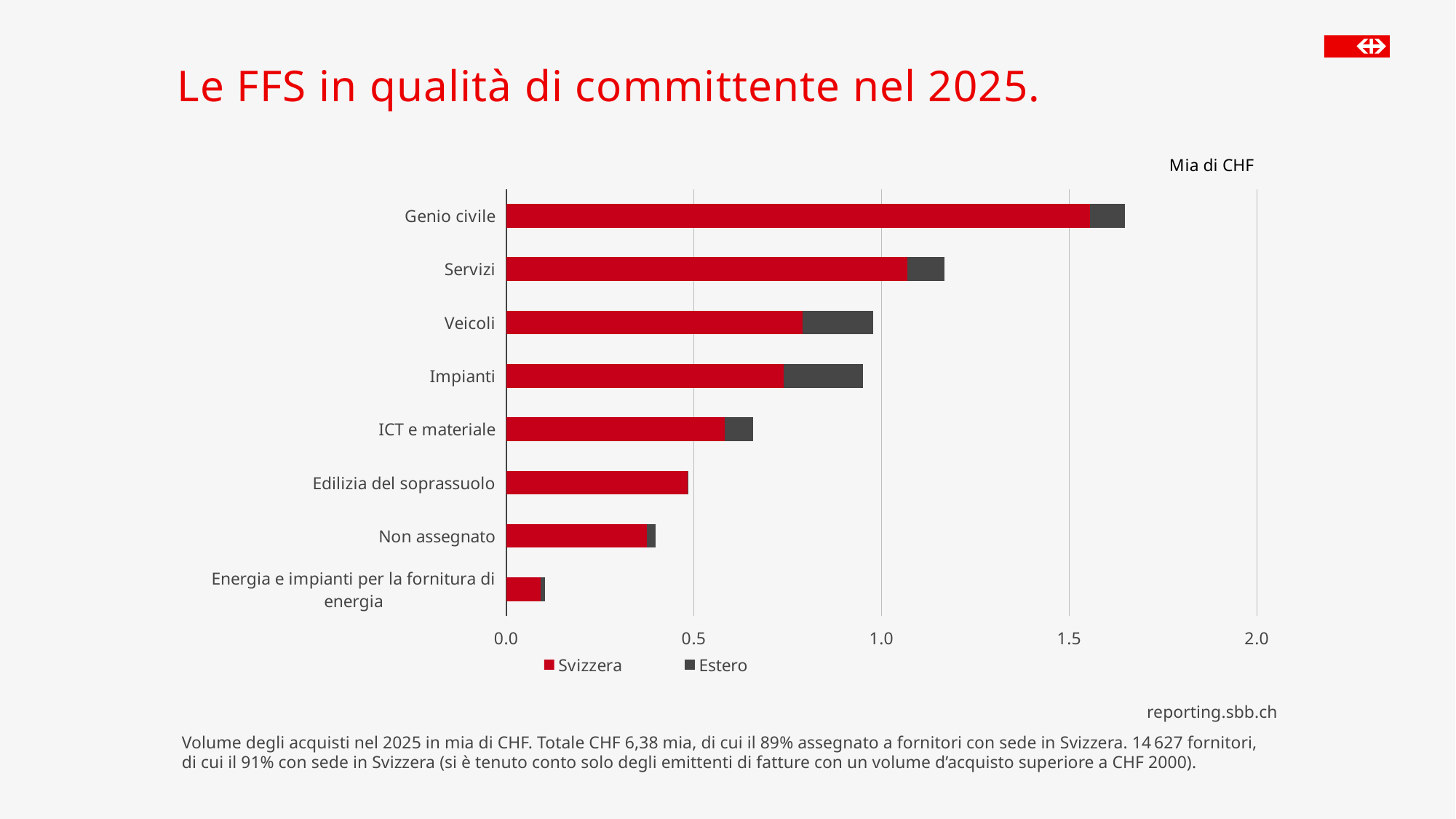
Which has the larger total bar, Servizi or Veicoli? Servizi Which category has the shortest bar in the chart? Energia e impianti per la fornitura di energia Which category has the longest bar in the chart? Genio civile How many series does the legend list? 2 Is the total value for Genio civile greater or less than 1.5? greater What unit is indicated above the chart? Mia di CHF Do the bar lengths increase or decrease from the top category to the bottom category? decrease How many categories are plotted in the chart? 8 What kind of chart is shown on the slide? bar chart Is the total value for Servizi greater or less than 1.0? greater Is the total value for Impianti greater or less than 1.0? less